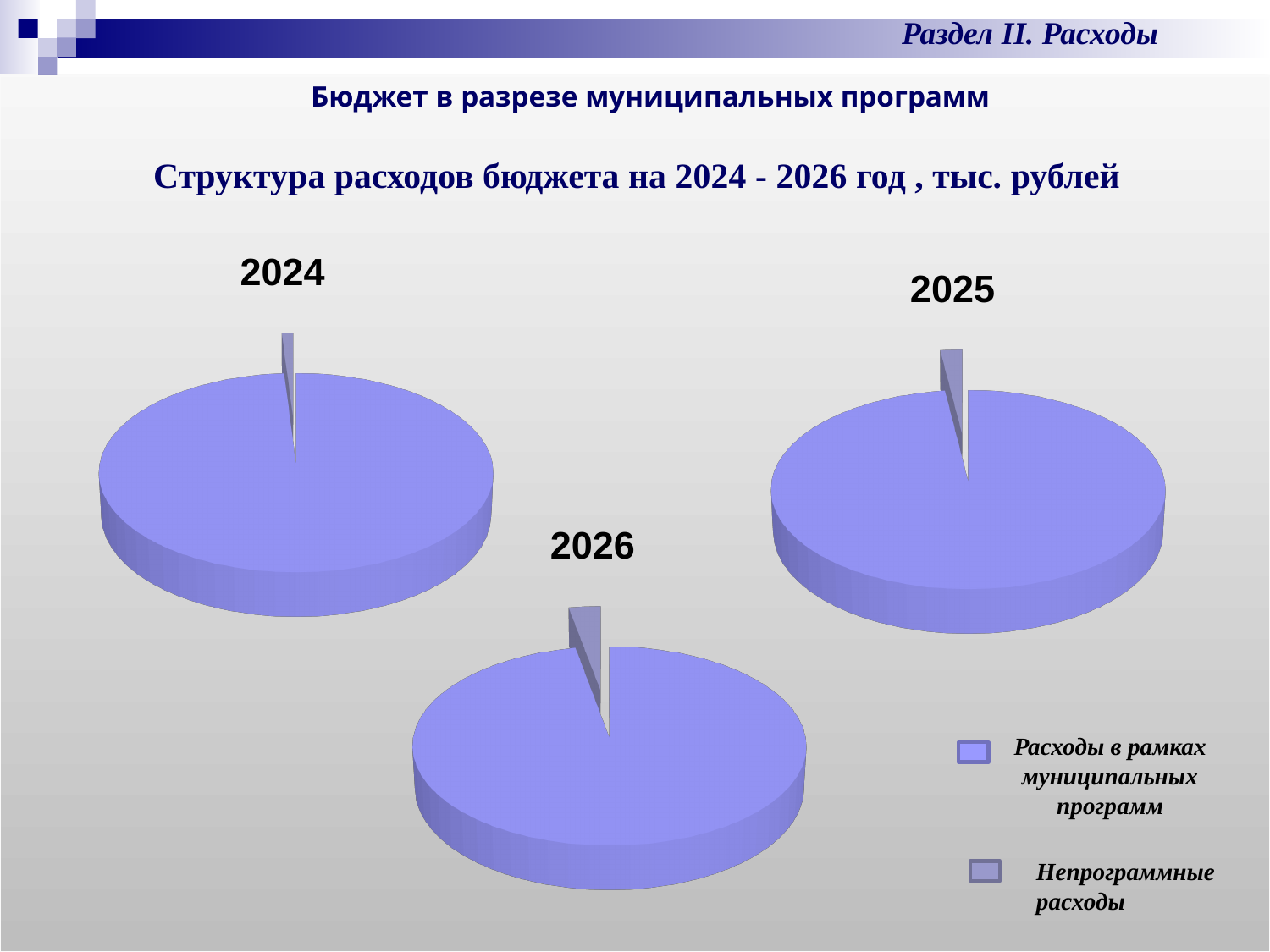
What kind of chart is used for the 2024 chart? pie chart How many slices does the 2025 pie chart have? 2 In the 2026 pie chart, is the slice for Непрограммные расходы larger or smaller than the slice for Расходы в рамках муниципальных программ? smaller What is the title above the three pie charts? Структура расходов бюджета на 2024 - 2026 год , тыс. рублей How many pie charts are shown on the slide? 3 How many categories does the legend list? 2 In the 2024 pie chart, which category has the larger slice? Расходы в рамках муниципальных программ Which years are shown as pie chart titles on the slide? 2024, 2025, 2026 In the 2025 pie chart, which category has the smaller slice? Непрограммные расходы In the 2026 pie chart, which category takes up most of the pie? Расходы в рамках муниципальных программ